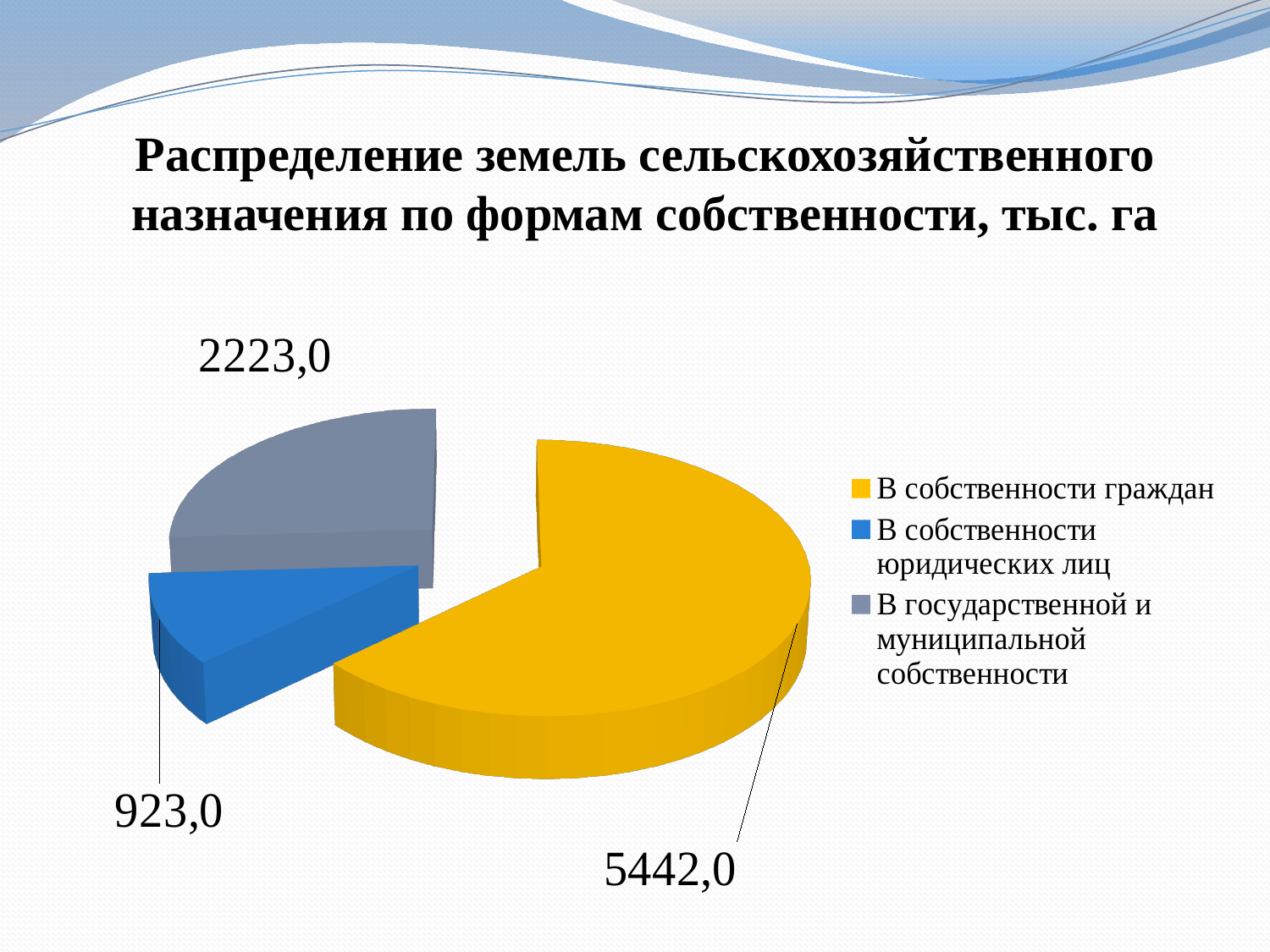
What colour is the slice for "В собственности граждан"? yellow What is the difference between the values for "В собственности граждан" and "В государственной и муниципальной собственности"? 3219,0 What is the value for "В собственности граждан"? 5442,0 What is the difference between the values for "В государственной и муниципальной собственности" and "В собственности юридических лиц"? 1300,0 Which is larger: the value for "В государственной и муниципальной собственности" or for "В собственности юридических лиц"? В государственной и муниципальной собственности What is the value for "В государственной и муниципальной собственности"? 2223,0 What is the total of all three slices of the pie chart? 8588,0 What is the value for "В собственности юридических лиц"? 923,0 How many slices does the pie chart have? 3 Which form of ownership has the largest share of the pie? В собственности граждан Which form of ownership has the smallest share of the pie? В собственности юридических лиц What type of chart is shown on the slide? pie chart